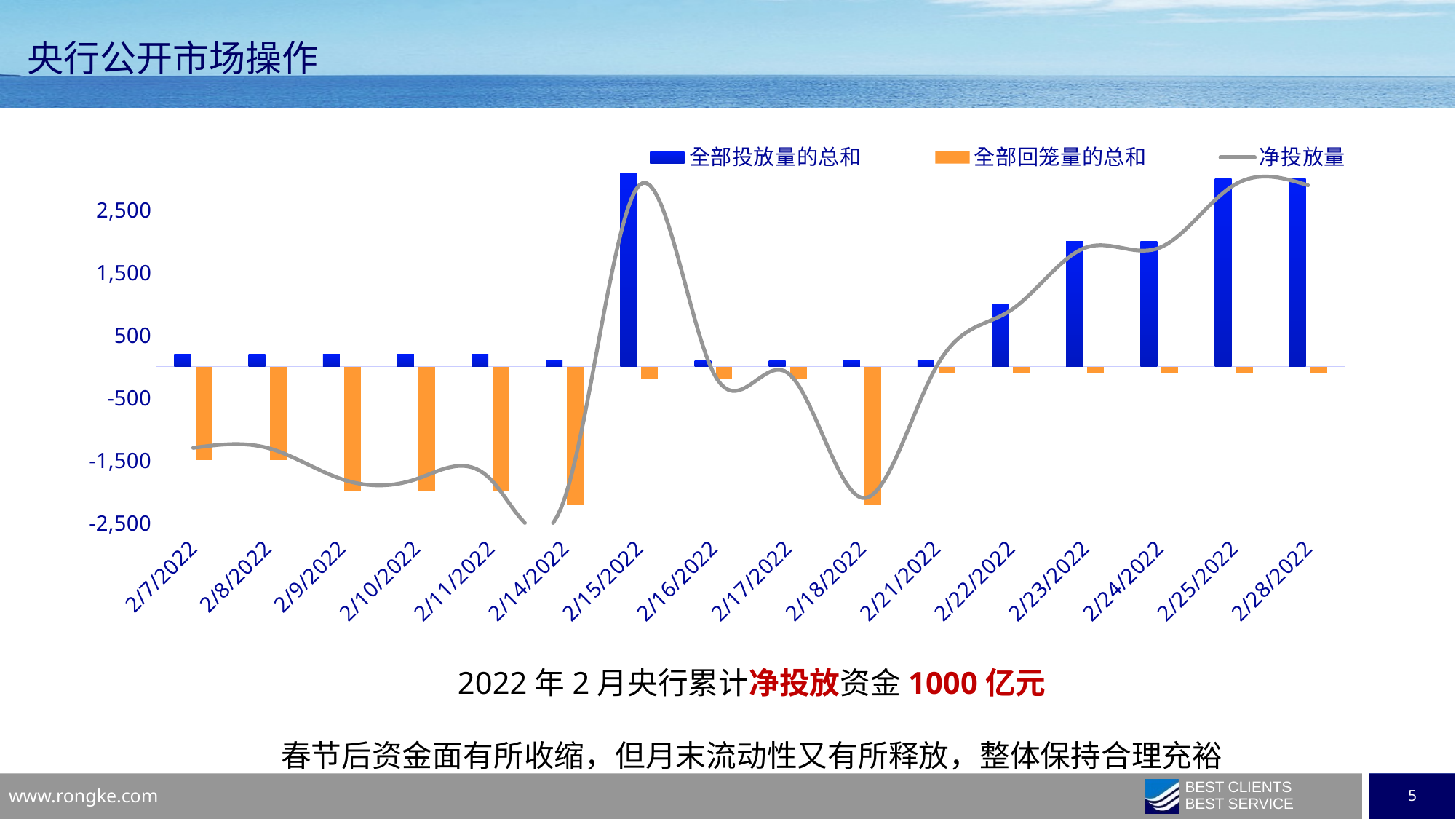
What colour are the bars for 全部回笼量的总和? Orange Which date has the larger 全部投放量的总和 value, 2/15/2022 or 2/22/2022? 2/15/2022 Which series is drawn as a line in the chart? 净投放量 Is the value for 全部投放量的总和 on 2/15/2022 greater or less than 2,500? greater What kind of chart is shown on the slide? Combined bar and line chart How many series does the chart legend list? 3 Does the 净投放量 line rise or fall from 2/21/2022 to 2/25/2022? Rise Is the value for 全部回笼量的总和 on 2/9/2022 greater or less than -1,500? less How many dates are shown on the x axis of the chart? 16 Is the value for 全部回笼量的总和 on 2/16/2022 greater or less than -500? greater